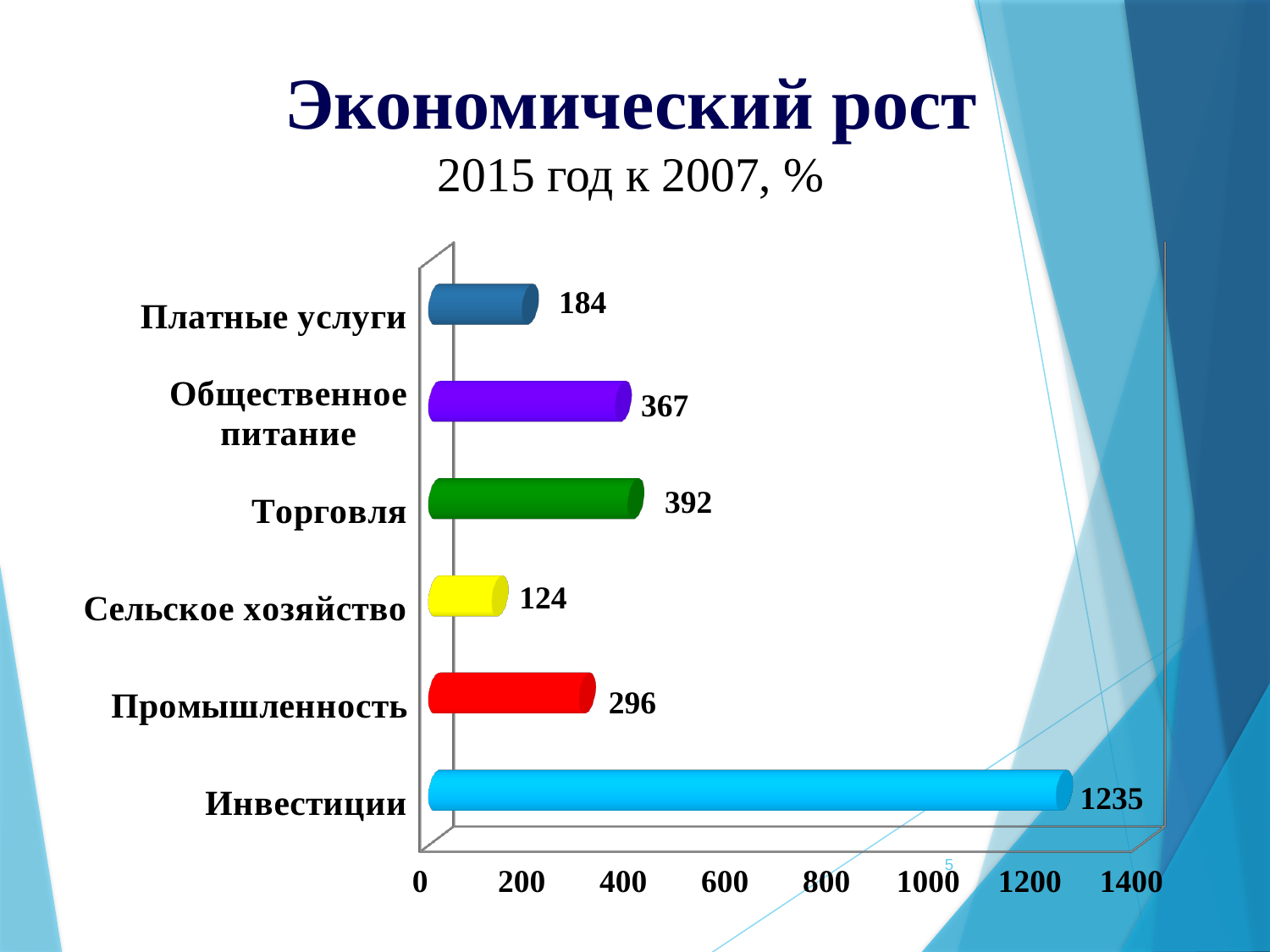
What is the value for Инвестиции? 1235 How many categories are shown in the chart? 6 What is the value for Платные услуги? 184 What is the difference between the values for Торговля and Общественное питание? 25 What is the value for Торговля? 392 Which is larger, the value for Промышленность or the value for Платные услуги? Промышленность Which category has the highest value? Инвестиции What is the subtitle shown under the chart title? 2015 год к 2007, % What is the value for Сельское хозяйство? 124 Which category has the lowest value? Сельское хозяйство What is the difference between the values for Промышленность and Сельское хозяйство? 172 What kind of chart is shown on the slide? bar chart